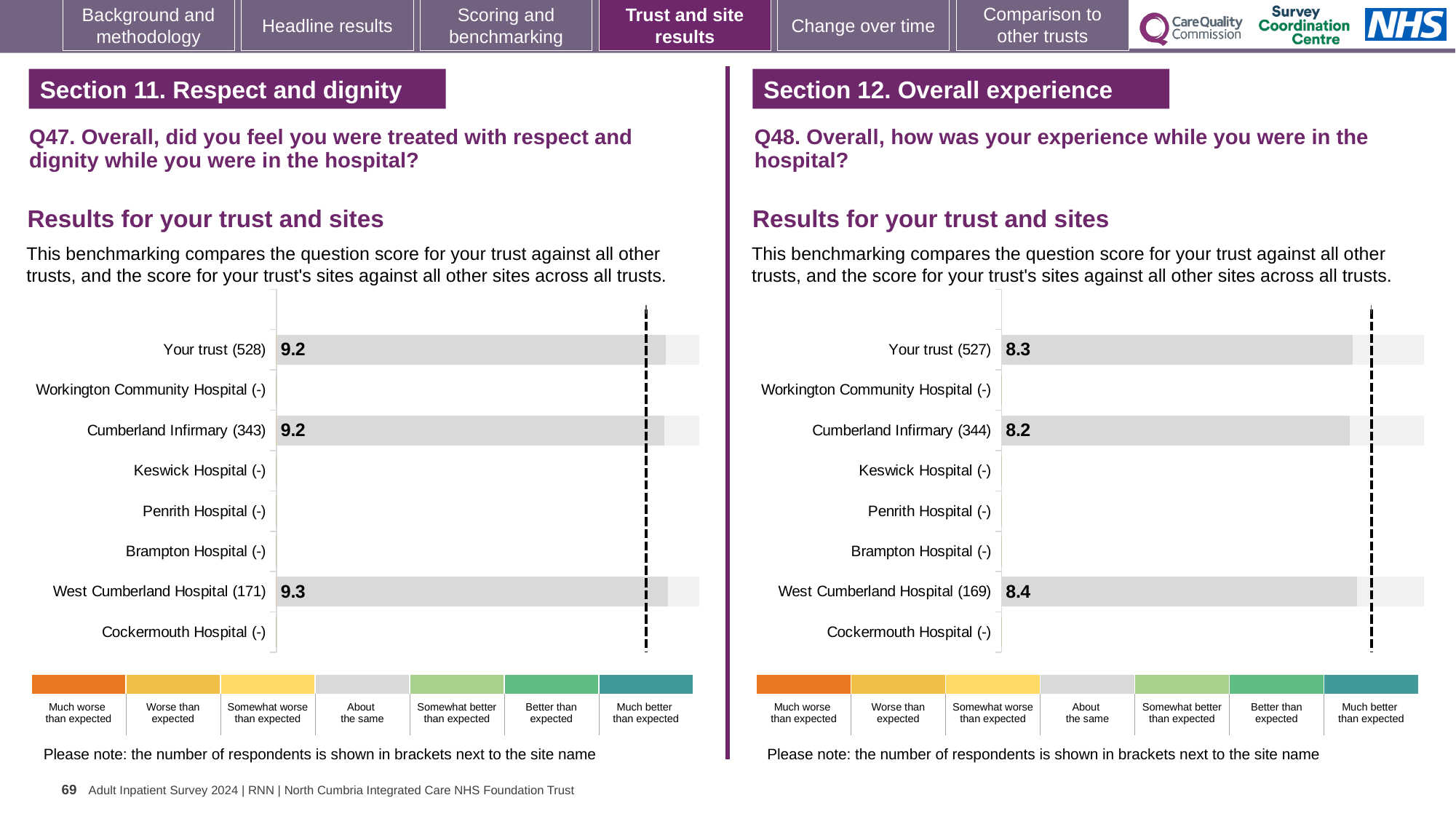
In the Q47 chart on the left, what is the score for West Cumberland Hospital? 9.3 In the Q47 chart on the left, what is the difference between the scores for West Cumberland Hospital and Cumberland Infirmary? 0.1 In the Q48 chart on the right, what is the difference between the scores for West Cumberland Hospital and Cumberland Infirmary? 0.2 In the Q47 chart on the left, how many respondents are shown in brackets for Cumberland Infirmary? 343 How many site/trust categories are listed on the y axis of the Q47 chart on the left? 8 In the Q47 chart on the left, what is the score for Your trust? 9.2 In the Q47 chart on the left, which site with a plotted score has the highest value? West Cumberland Hospital In the Q48 chart on the right, what is the score for Your trust? 8.3 In the Q48 chart on the right, is the score for West Cumberland Hospital larger or smaller than the score for Your trust? larger In the Q48 chart on the right, what is the score for Cumberland Infirmary? 8.2 What kind of chart is used in the Q48 chart on the right? bar chart In the Q48 chart on the right, which site with a plotted score has the lowest value? Cumberland Infirmary